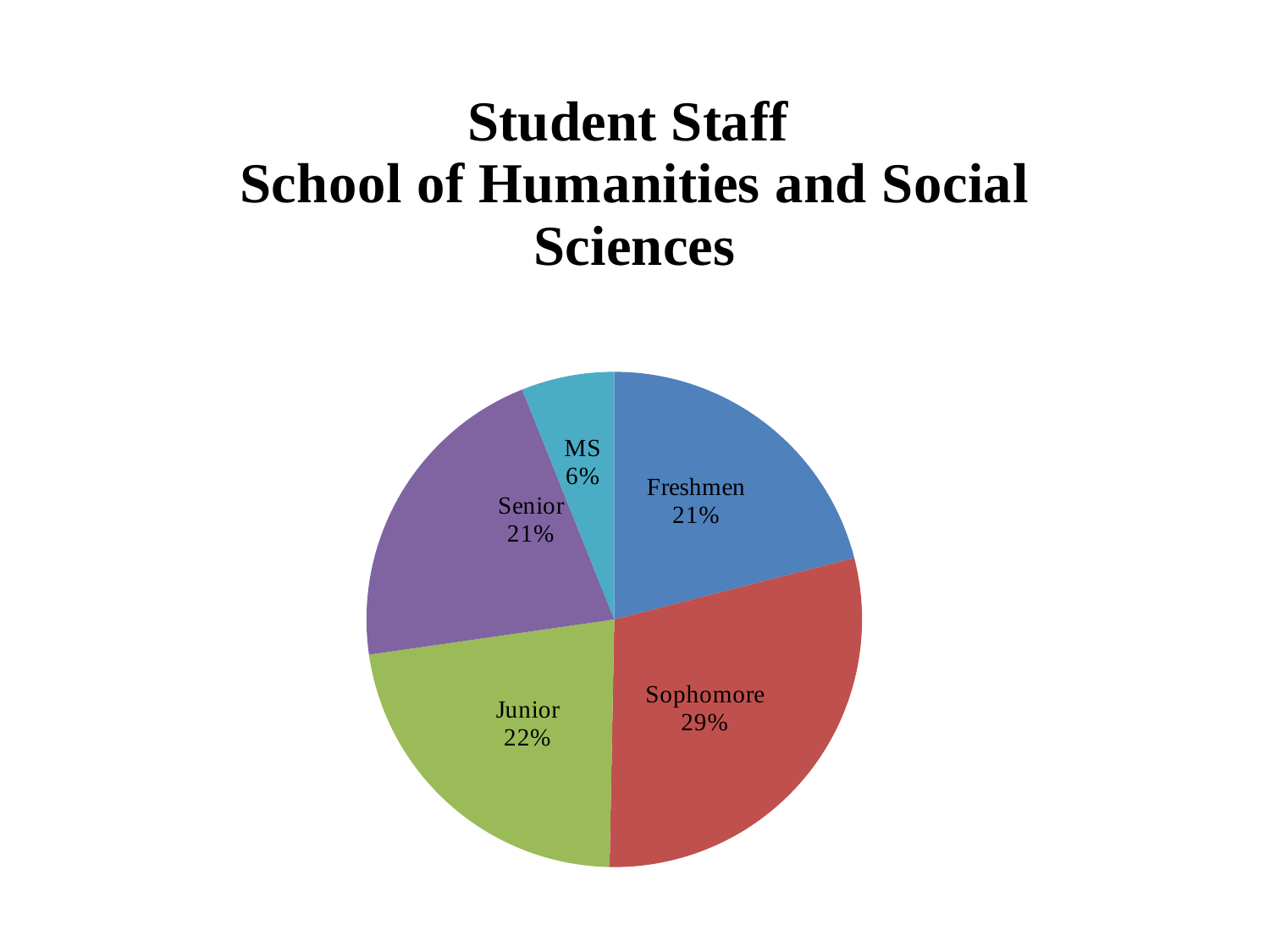
What is the difference in percentage points between Sophomore and Junior? 7 What share of the pie does Junior represent? 22% What share of the pie does Freshmen represent? 21% What is the difference in percentage points between Senior and MS? 15 Which category has the smallest slice of the pie? MS What type of chart is shown on the slide? pie chart What is the title of the chart? Student Staff School of Humanities and Social Sciences How many slices does the pie chart have? 5 Which category has the largest slice of the pie? Sophomore Which is larger, the Junior slice or the MS slice? Junior What share of the pie does MS represent? 6%